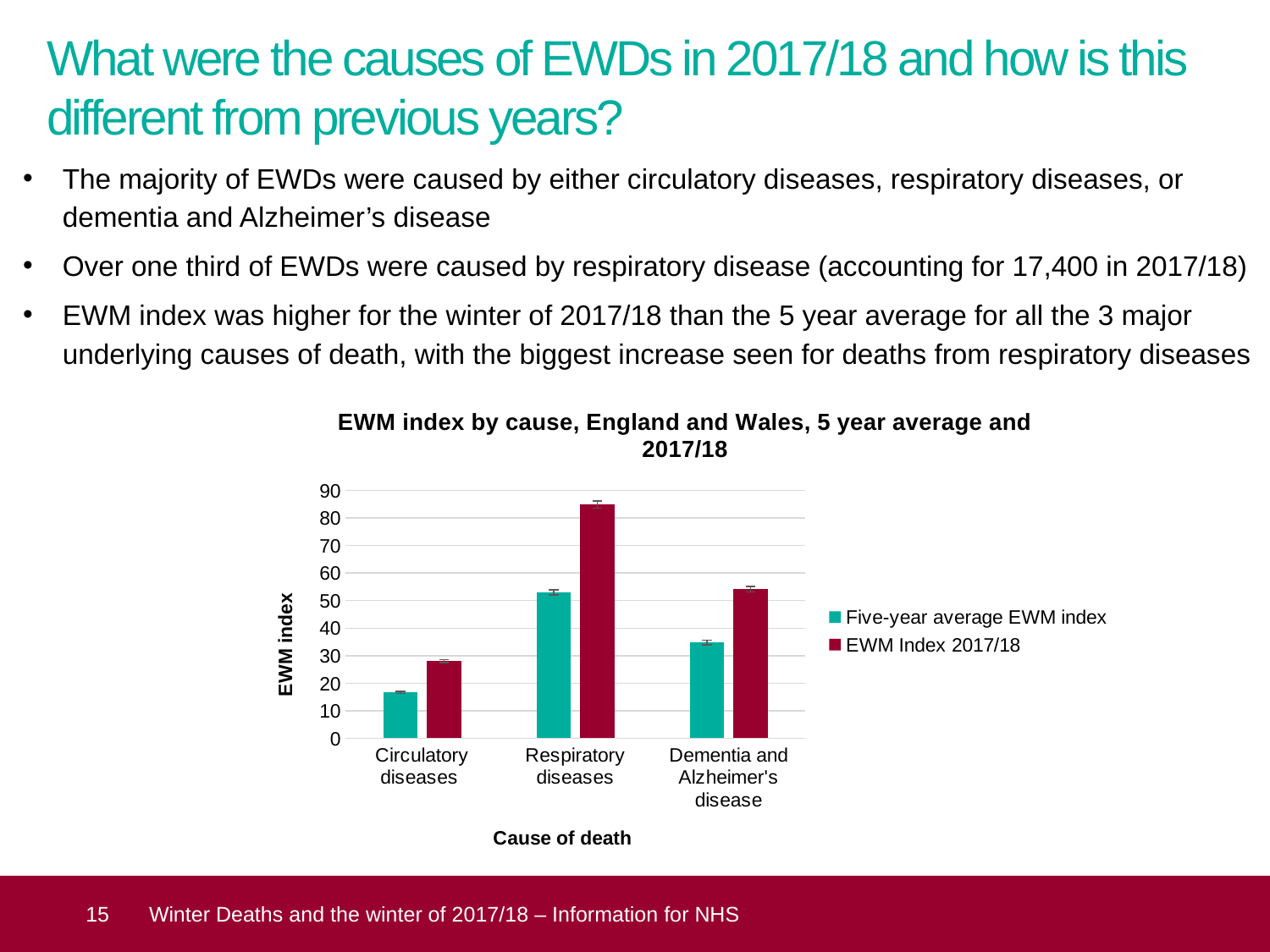
What kind of chart is shown on the slide? bar chart Is the five-year average EWM index for circulatory diseases greater or less than 20? less How many series does the legend list? 2 What is the title of the chart? EWM index by cause, England and Wales, 5 year average and 2017/18 Which is larger: the EWM Index 2017/18 for circulatory diseases or the five-year average EWM index for respiratory diseases? Five-year average EWM index for respiratory diseases Is the five-year average EWM index for dementia and Alzheimer's disease greater or less than 30? greater Which cause of death has the highest EWM Index 2017/18? Respiratory diseases Is the EWM Index 2017/18 for circulatory diseases greater or less than 30? less For dementia and Alzheimer's disease, which is larger: the five-year average EWM index or the EWM Index 2017/18? EWM Index 2017/18 How many causes of death are shown on the x axis? 3 Which cause of death has the lowest five-year average EWM index? Circulatory diseases